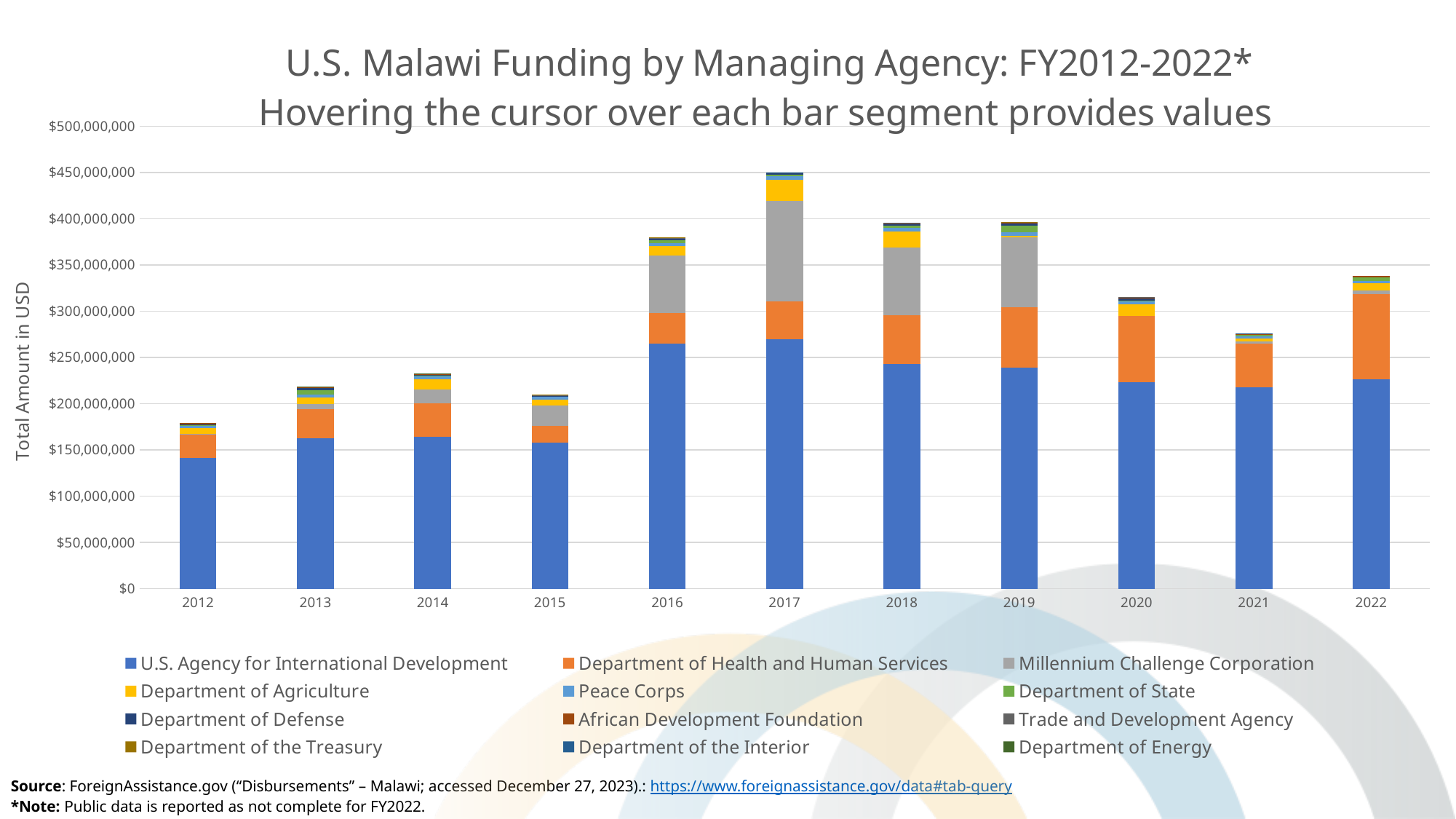
What kind of chart is shown on the slide? Stacked bar chart Is the total funding for 2021 greater or less than $300,000,000? less Is the total funding for 2017 greater or less than $400,000,000? greater Is the total funding for 2012 greater or less than $200,000,000? less Which year has the larger total funding, 2020 or 2021? 2020 Which year has the lowest total funding? 2012 Which year has the larger total funding, 2015 or 2016? 2016 Do the total funding amounts generally rise or fall from 2012 to 2017? rise How many fiscal years are shown along the x axis? 11 Which year has the highest total funding? 2017 Which agency forms the bottom (blue) segment of every bar? U.S. Agency for International Development How many managing agencies does the legend list? 12